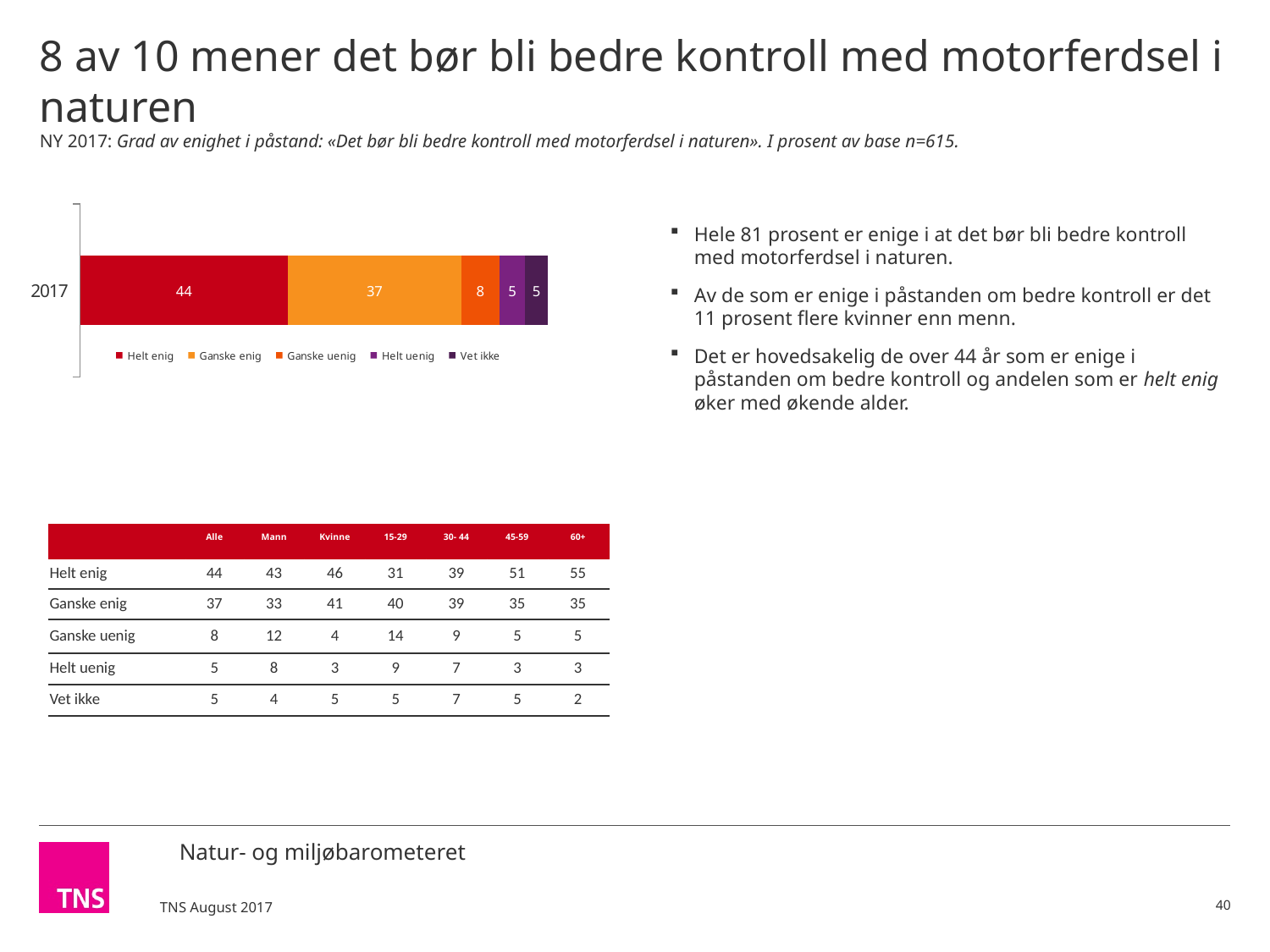
What is the category label shown on the axis of the chart? 2017 What type of chart is shown on the slide? Stacked bar chart Which series has the largest segment in the 2017 bar? Helt enig What is the value for Ganske uenig in the 2017 bar? 8 How many series does the legend list? 5 Which is larger in the 2017 bar, Ganske uenig or Helt uenig? Ganske uenig What is the total of the 2017 stacked bar? 99 What is the value for Helt enig in the 2017 bar? 44 What is the value for Helt uenig in the 2017 bar? 5 What is the value for Ganske enig in the 2017 bar? 37 How many bars (categories) are plotted in the chart? 1 What is the difference between the Helt enig and Ganske enig values in the 2017 bar? 7